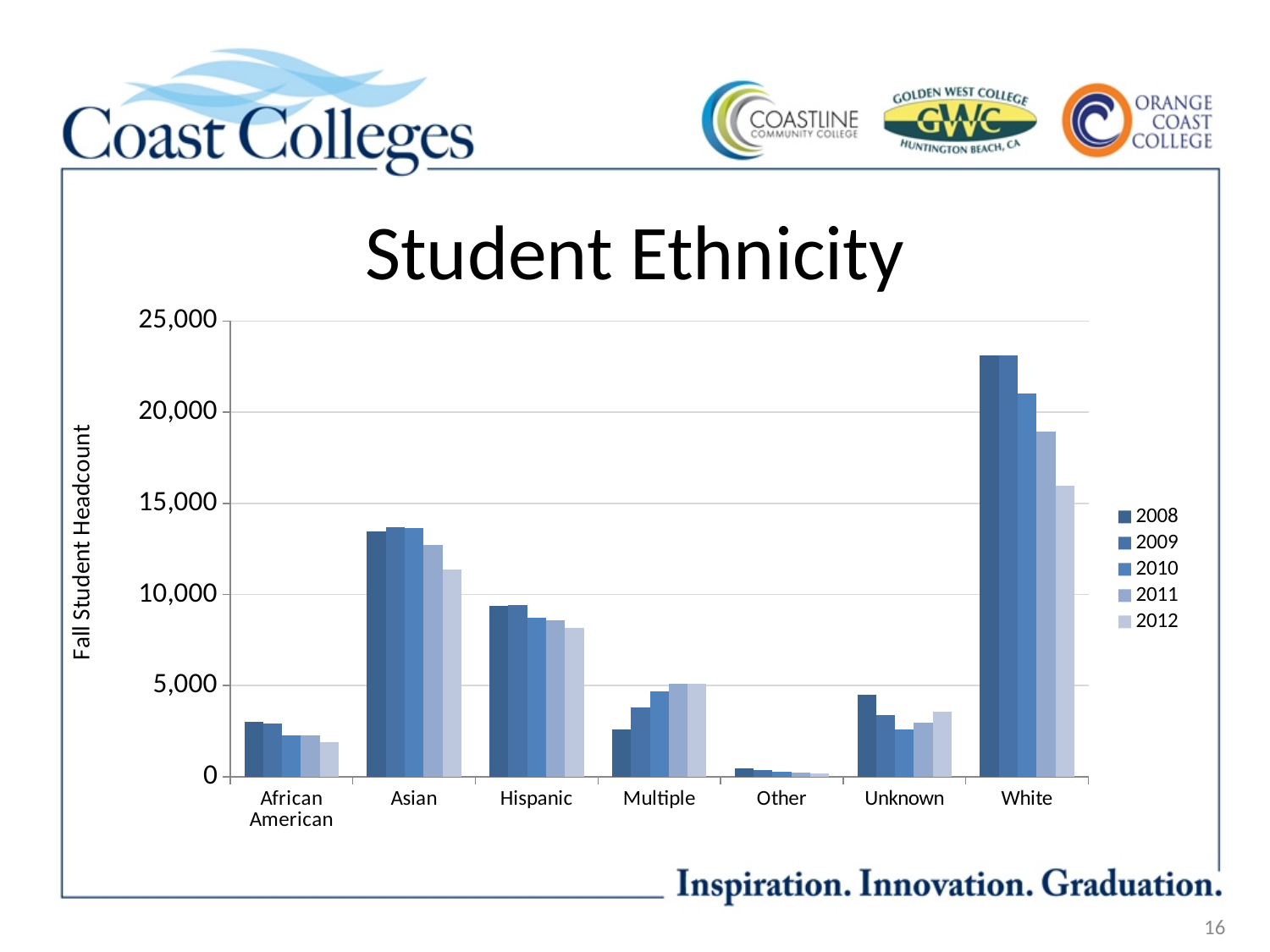
Does the headcount for Multiple rise or fall from 2008 to 2012? rise What kind of chart is shown on the slide? Bar chart Which ethnicity category has the lowest headcount across all years? Other How many series does the legend list? 5 Which ethnicity category has the highest headcount in 2008? White Is the 2008 headcount for White greater or less than 20,000? greater What is the title of the vertical axis? Fall Student Headcount Is the 2012 headcount for Asian greater or less than 10,000? greater How many ethnicity categories are shown on the x axis? 7 Does the headcount for White rise or fall from 2008 to 2012? fall In 2008, which has the larger headcount, Unknown or Multiple? Unknown Is the 2008 headcount for Hispanic greater or less than 10,000? less